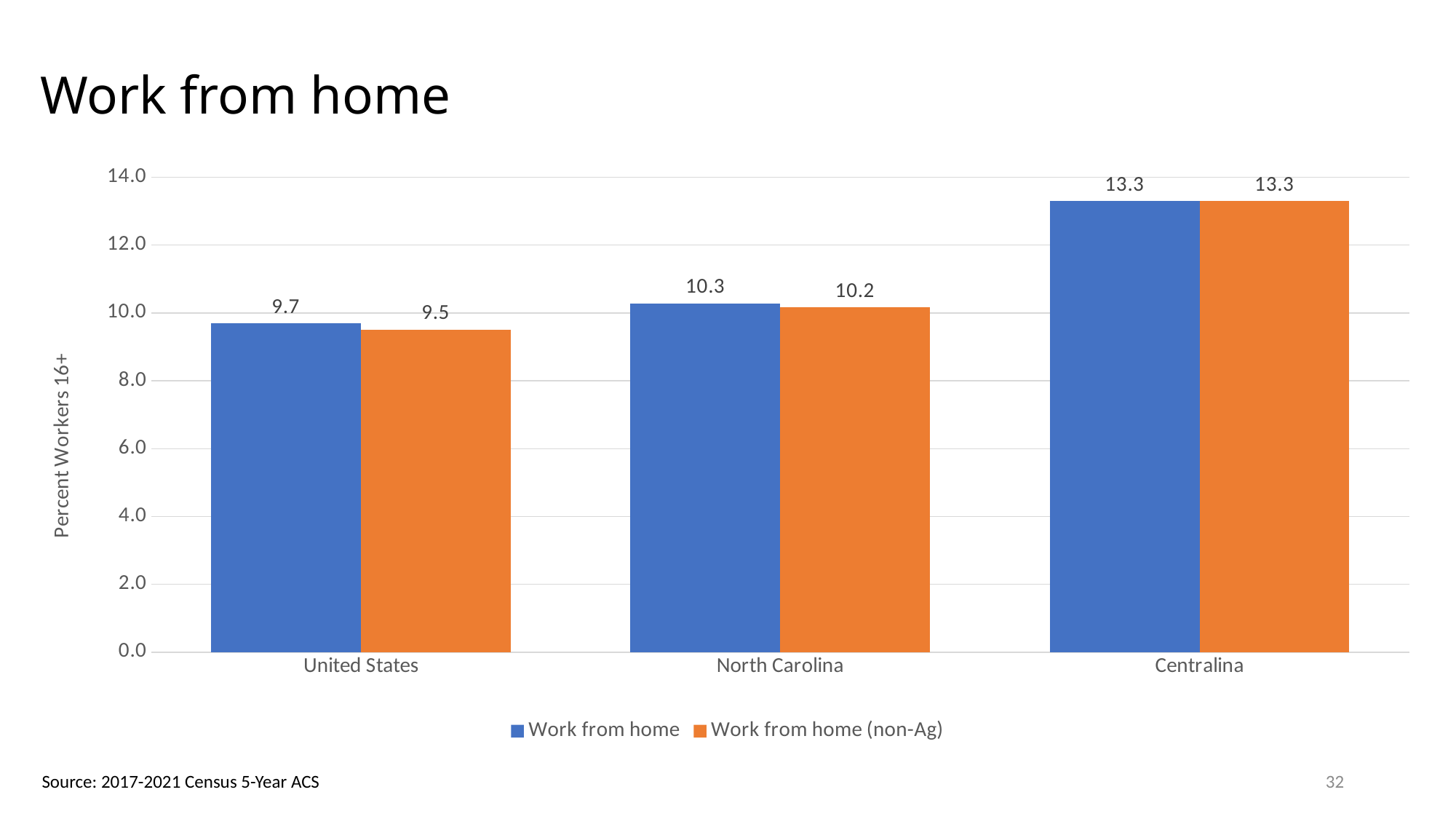
What is the difference between the Work from home and Work from home (non-Ag) values for North Carolina? 0.1 How many regions are shown on the x axis? 3 Which region has the highest Work from home value? Centralina What kind of chart is shown on the slide? Bar chart Is the Work from home (non-Ag) value for Centralina greater or less than 12.0? greater How many series does the legend list? 2 What is the Work from home (non-Ag) value for the United States? 9.5 What is the Work from home value for North Carolina? 10.3 Which region has the lowest Work from home (non-Ag) value? United States What is the Work from home value for Centralina? 13.3 Which is larger: the Work from home value for North Carolina or for the United States? North Carolina What is the difference between the Work from home values for Centralina and the United States? 3.6